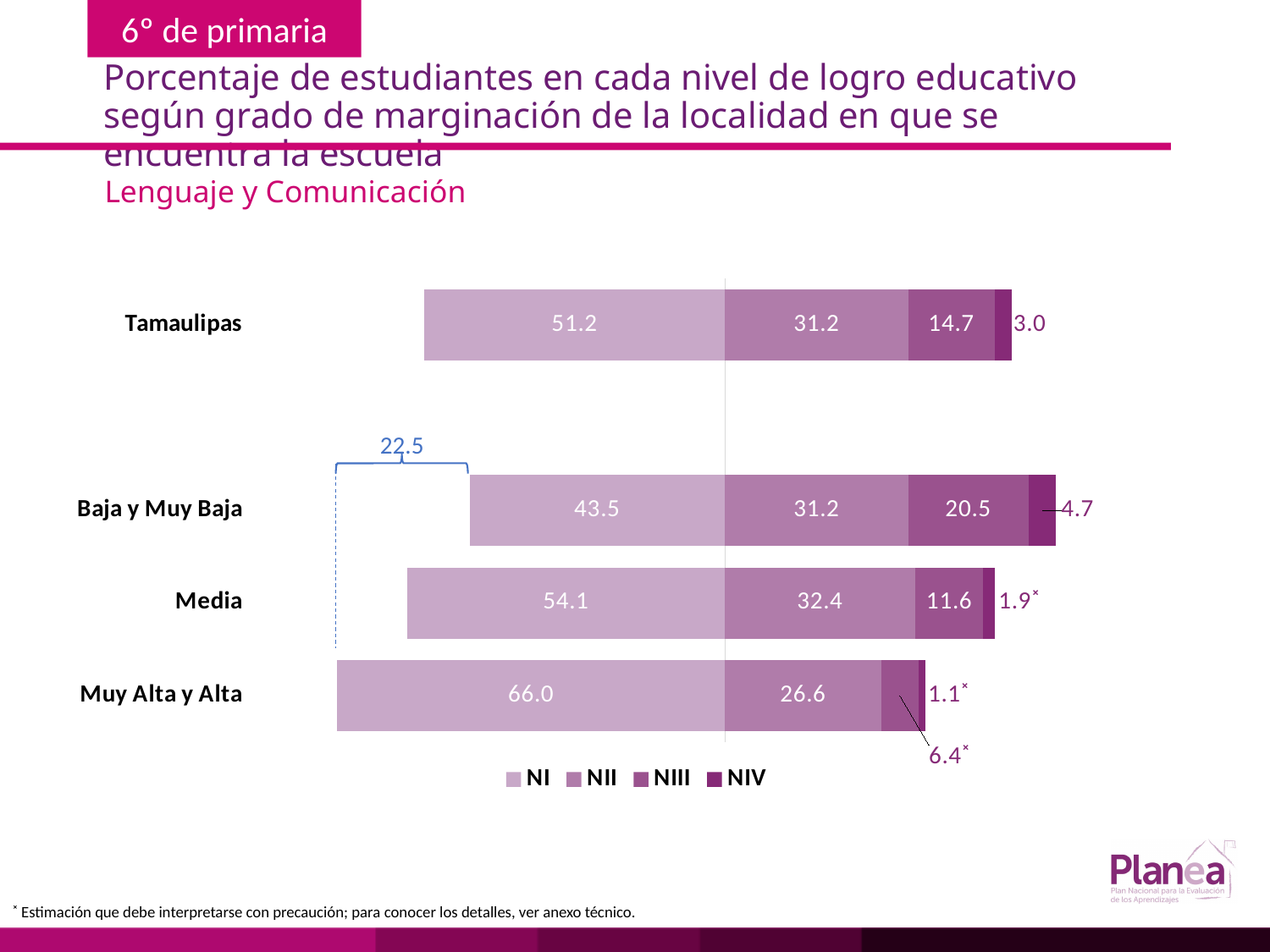
How many series does the legend list? 4 What is the NIV value for the Media category? 1.9 What is the NII value for Muy Alta y Alta? 26.6 Which category has the lowest NI value? Baja y Muy Baja What is the difference between the NI values of Muy Alta y Alta and Baja y Muy Baja? 22.5 What is the difference between the NIII values of Baja y Muy Baja and Tamaulipas? 5.8 Which category has the highest NIV value? Baja y Muy Baja Which is larger, the NII value for Media or the NII value for Tamaulipas? Media What kind of chart is shown on the slide? Stacked bar chart What is the NIII value for the Baja y Muy Baja category? 20.5 Which category has the highest NI value? Muy Alta y Alta What percentage of students in Tamaulipas are at level NI? 51.2